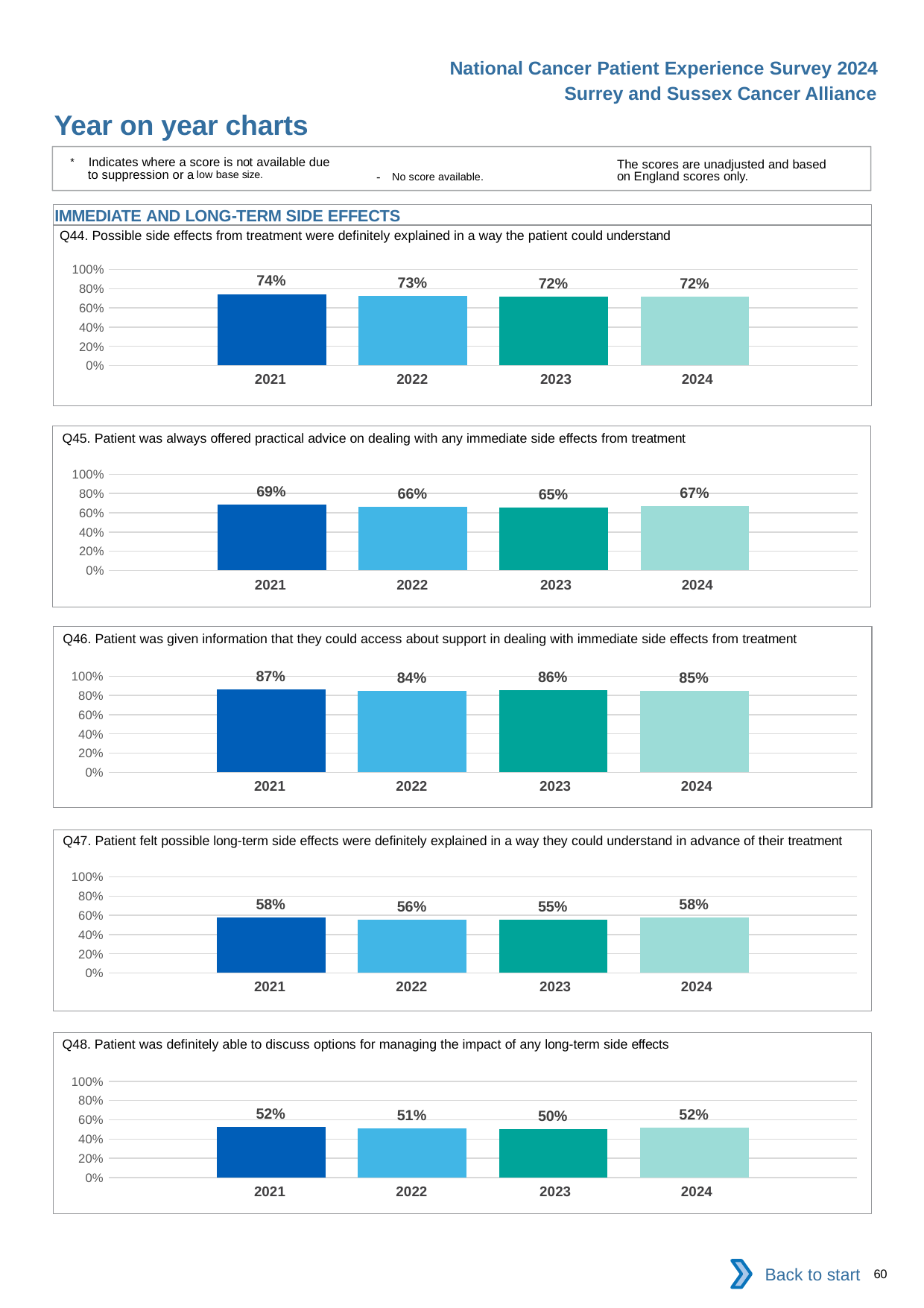
In the Q47 chart, is the value for 2022 greater or less than 60%? less In the Q44 chart, do the values rise or fall from 2021 to 2024? fall In the Q46 chart, what is the difference between the 2021 and 2022 values? 3% In the Q47 chart, what is the value for 2023? 55% In the Q45 chart, which is larger, the value for 2021 or the value for 2024? 2021 What kind of chart is the Q47 chart? bar chart How many years are shown in the Q44 chart? 4 In the Q48 chart, which year has the lowest value? 2023 In the Q44 chart, what is the value for 2021? 74% In the Q45 chart, which year has the lowest value? 2023 In the Q46 chart, which year has the highest value? 2021 In the Q48 chart, what is the difference between the 2024 and 2023 values? 2%